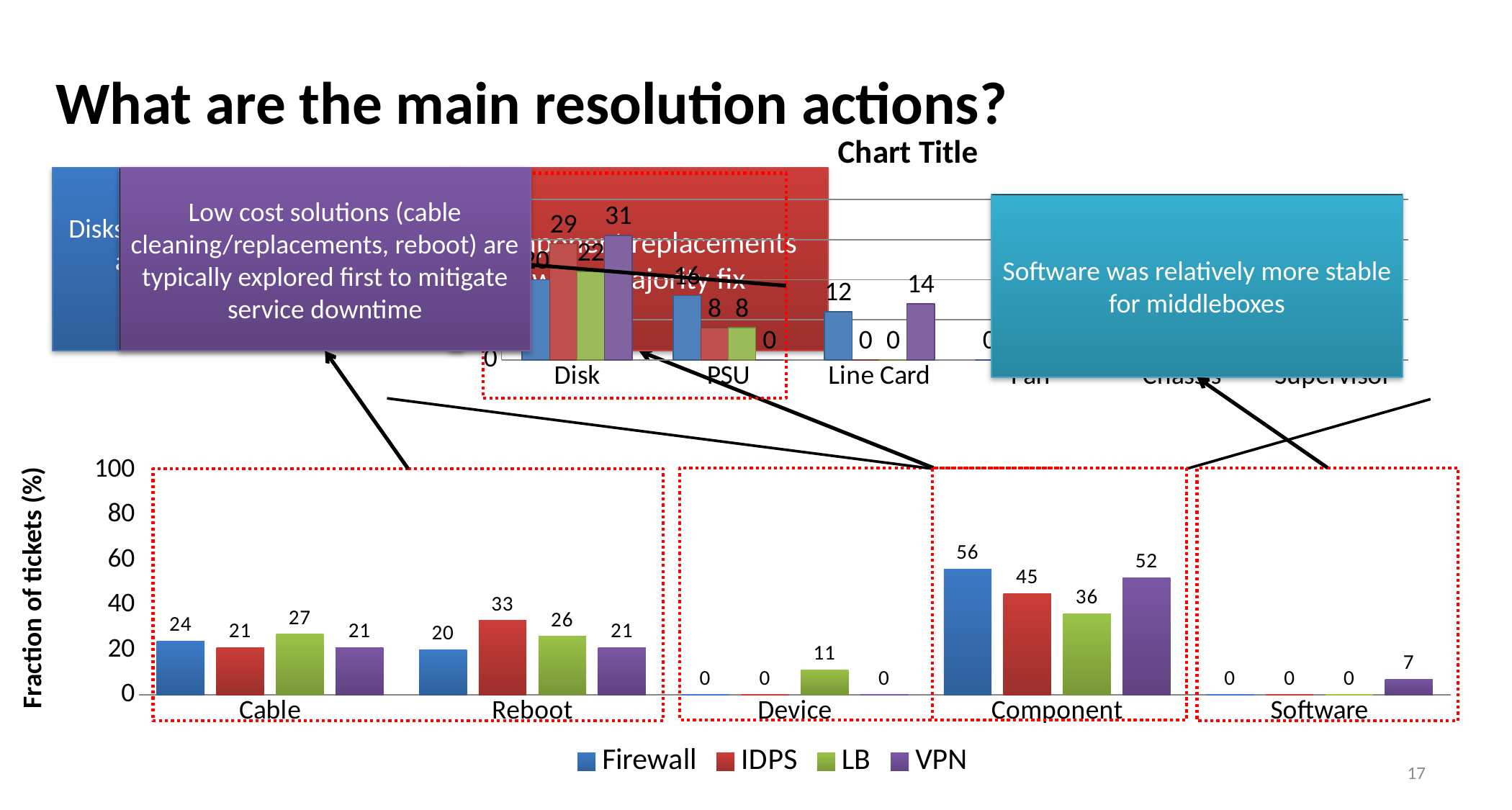
In the bottom chart, which series has the highest value in the Component category? Firewall In the bottom chart, which series has the lowest value in the Component category? LB What is the y-axis label of the bottom chart? Fraction of tickets (%) In the bottom chart, what is the value for LB in the Component category? 36 In the bottom chart, is the Firewall value for Component greater or less than 40? greater How many categories are shown on the x axis of the bottom chart? 5 How many series does the legend of the bottom chart list? 4 In the bottom chart, what is the value for VPN in the Software category? 7 In the bottom chart, what is the difference between the Firewall and IDPS values in the Component category? 11 In the bottom chart, which is larger: the LB value for Cable or the LB value for Reboot? Cable What kind of chart is the bottom chart? bar chart In the bottom chart, what is the value for IDPS in the Reboot category? 33